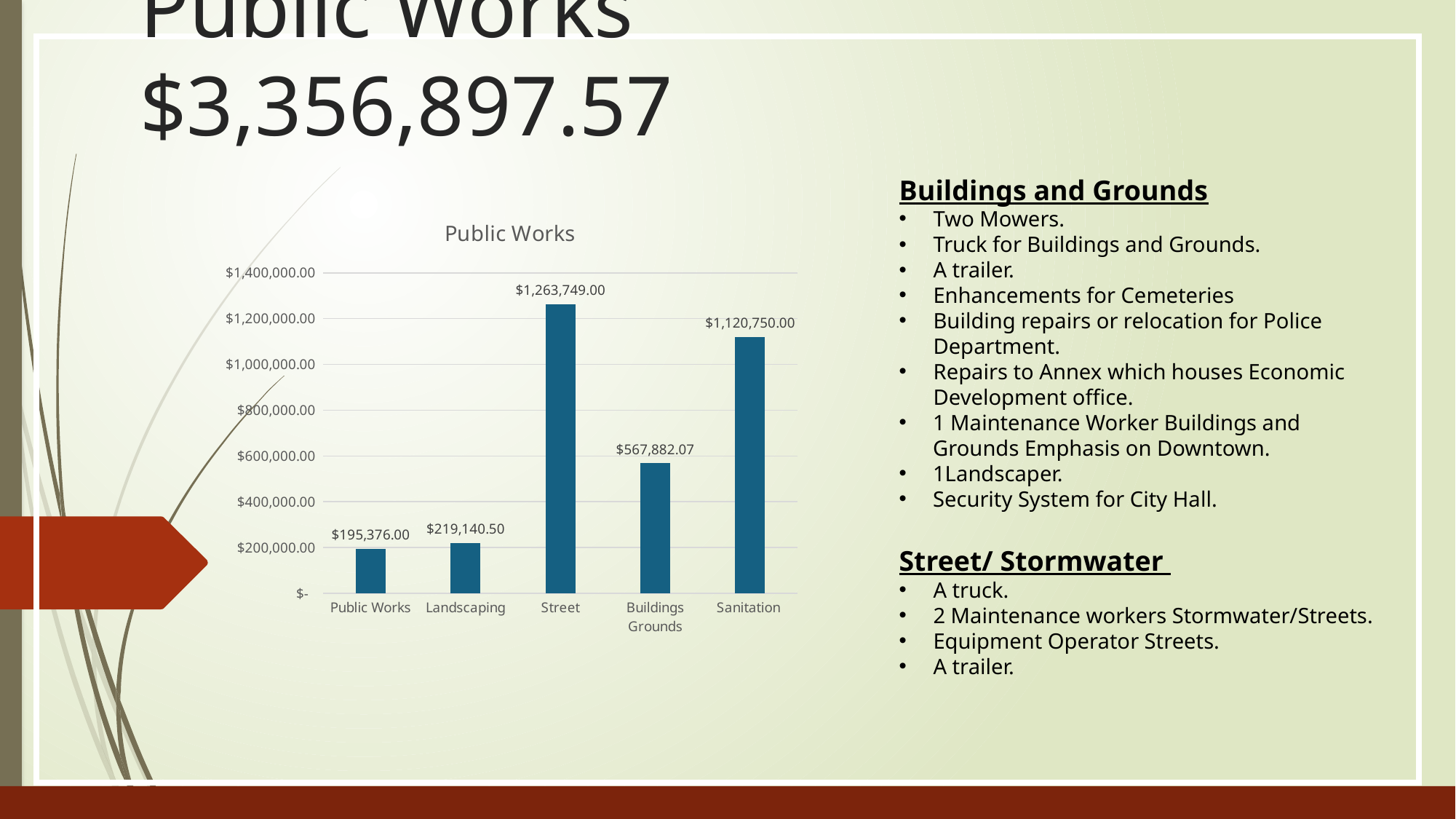
What is the value for Landscaping in the Public Works chart? $219,140.50 What is the value for Buildings Grounds in the Public Works chart? $567,882.07 What is the value for Street in the Public Works chart? $1,263,749.00 What is the value for Sanitation in the Public Works chart? $1,120,750.00 Which category has the lowest value in the Public Works chart? Public Works What kind of chart is the Public Works chart? bar chart What is the difference between the Landscaping and Public Works values in the Public Works chart? $23,764.50 Is the value for Buildings Grounds in the Public Works chart greater or less than $400,000.00? greater Which category has the highest value in the Public Works chart? Street What is the difference between the Street and Sanitation values in the Public Works chart? $142,999.00 How many categories are shown in the Public Works chart? 5 Which is larger in the Public Works chart, Buildings Grounds or Sanitation? Sanitation